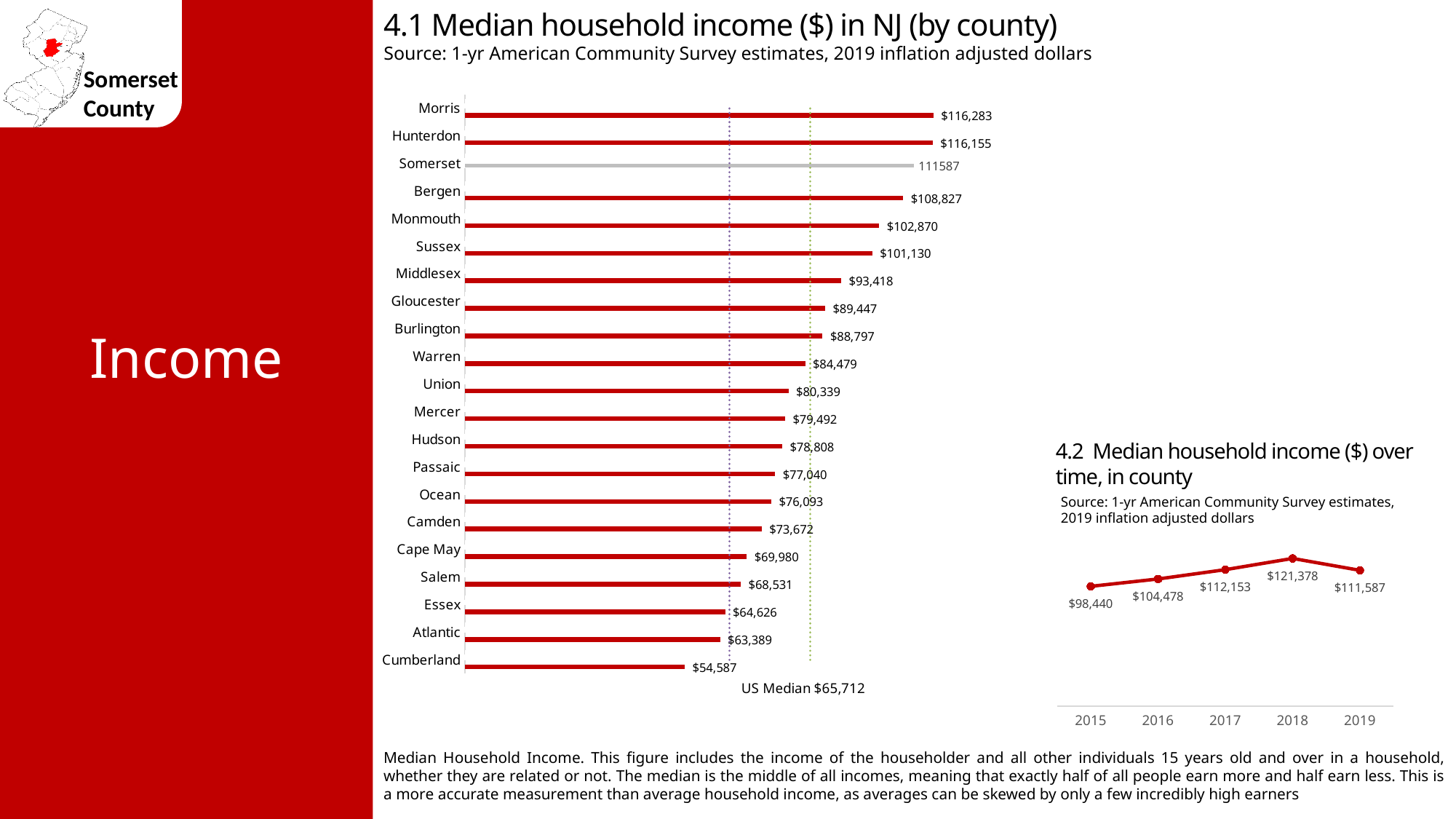
In chart 4.1, which county has the lowest median household income? Cumberland In chart 4.2, what is the difference between the 2018 and 2019 values? $9,791 In chart 4.2 (Median household income over time, in county), what is the value for 2017? $112,153 In chart 4.1, what is the US Median value shown? $65,712 In chart 4.2, which year has the highest median household income? 2018 What kind of chart is chart 4.1? Bar chart In chart 4.1, what value is shown for Somerset? 111587 In chart 4.2, how many years are plotted on the x axis? 5 In chart 4.1, what is the difference between the median household income of Bergen and Monmouth? $5,957 In chart 4.1 (Median household income by county), what is the median household income for Bergen? $108,827 In chart 4.1, which county has a higher median household income, Middlesex or Gloucester? Middlesex In chart 4.1, how many counties are plotted? 21